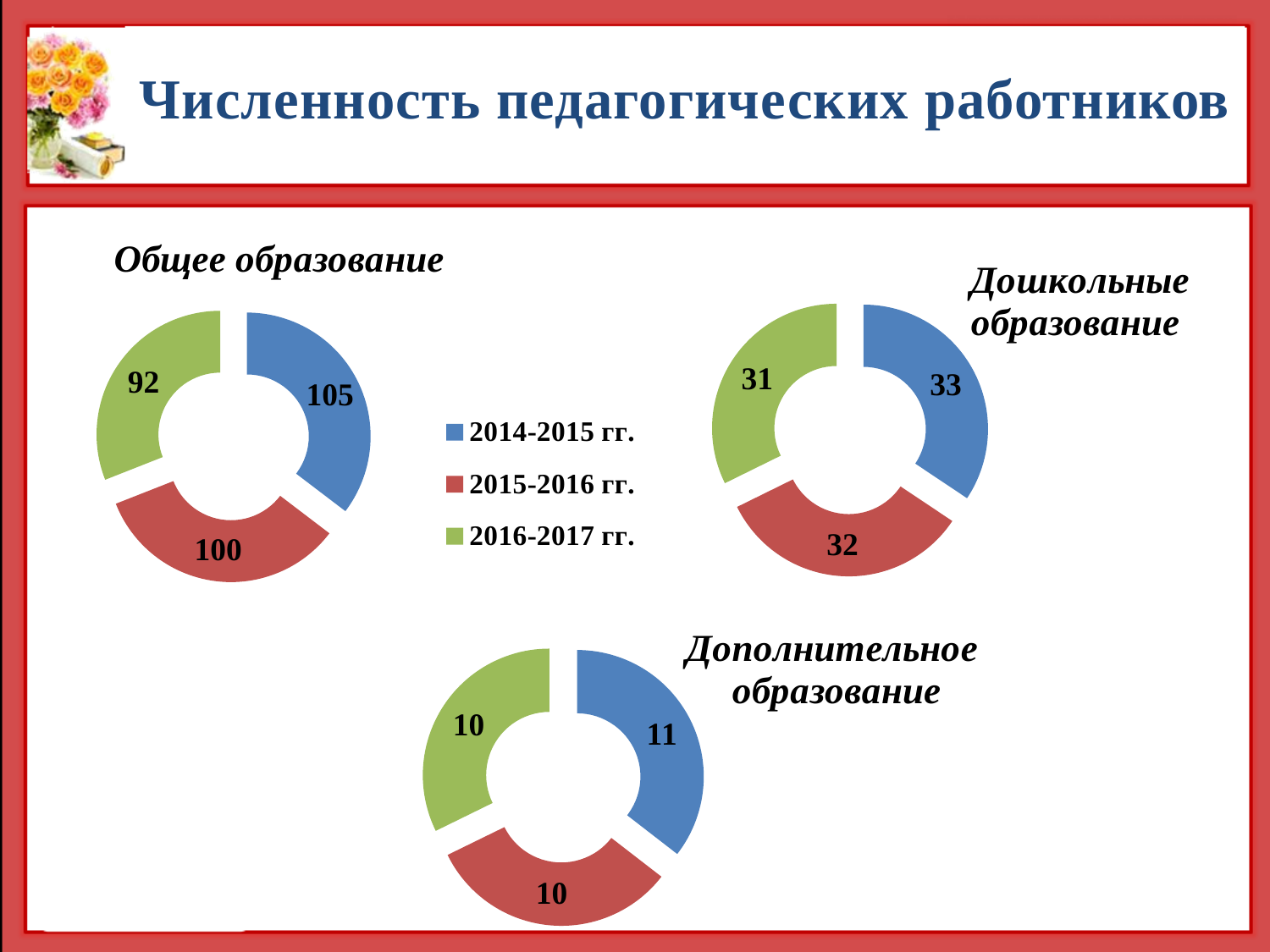
In the "Общее образование" chart, what is the value for 2014-2015 гг.? 105 In the "Общее образование" chart, what is the value for 2016-2017 гг.? 92 In the "Общее образование" chart, do the values rise or fall from 2014-2015 гг. to 2016-2017 гг.? Fall In the "Дополнительное образование" chart, what is the value for 2014-2015 гг.? 11 In the "Общее образование" chart, what is the difference between the values for 2014-2015 гг. and 2016-2017 гг.? 13 What kind of chart is the "Дополнительное образование" chart? Doughnut chart In the "Общее образование" chart, which is larger: the value for 2015-2016 гг. or 2016-2017 гг.? 2015-2016 гг. In the "Дошкольные образование" chart, which year has the highest value? 2014-2015 гг. In the "Дошкольные образование" chart, what is the difference between the values for 2015-2016 гг. and 2016-2017 гг.? 1 In the "Общее образование" chart, which year has the lowest value? 2016-2017 гг. In the "Дошкольные образование" chart, what is the value for 2015-2016 гг.? 32 How many series does the legend list? 3